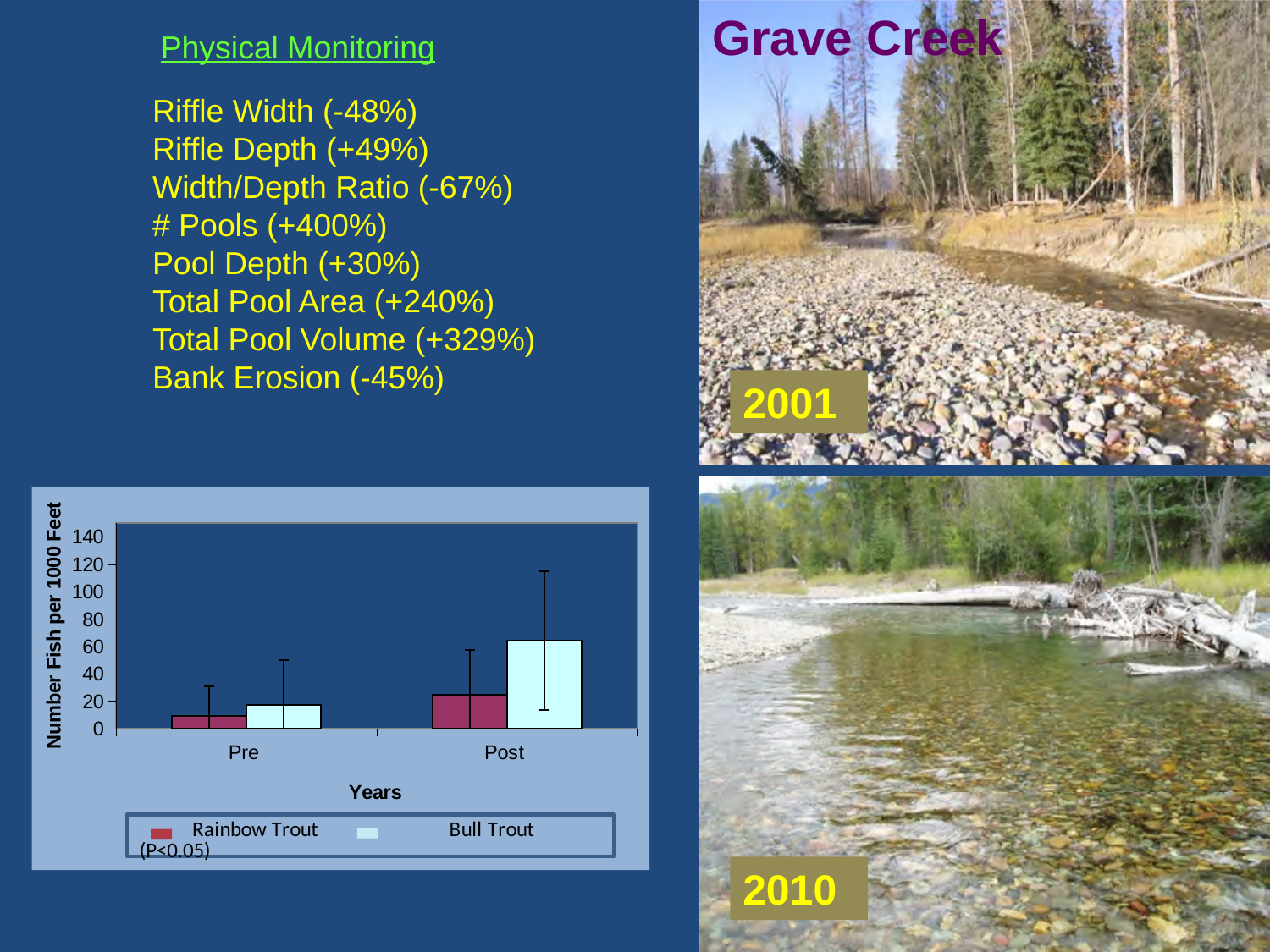
How many series does the chart's legend list? 2 What kind of chart is shown on the slide? bar chart Do the Bull Trout values rise or fall from Pre to Post? rise Is the Rainbow Trout value for Pre greater or less than 20? less Is the Bull Trout value for Post greater or less than 40? greater What is the title of the chart's y axis? Number Fish per 1000 Feet In the Post category, which is larger: Rainbow Trout or Bull Trout? Bull Trout Which series and category has the shortest bar in the chart? Rainbow Trout, Pre Which series and category has the tallest bar in the chart? Bull Trout, Post What is the title of the chart's x axis? Years Is the Rainbow Trout value for Post greater or less than 40? less How many categories are shown on the x axis of the chart? 2